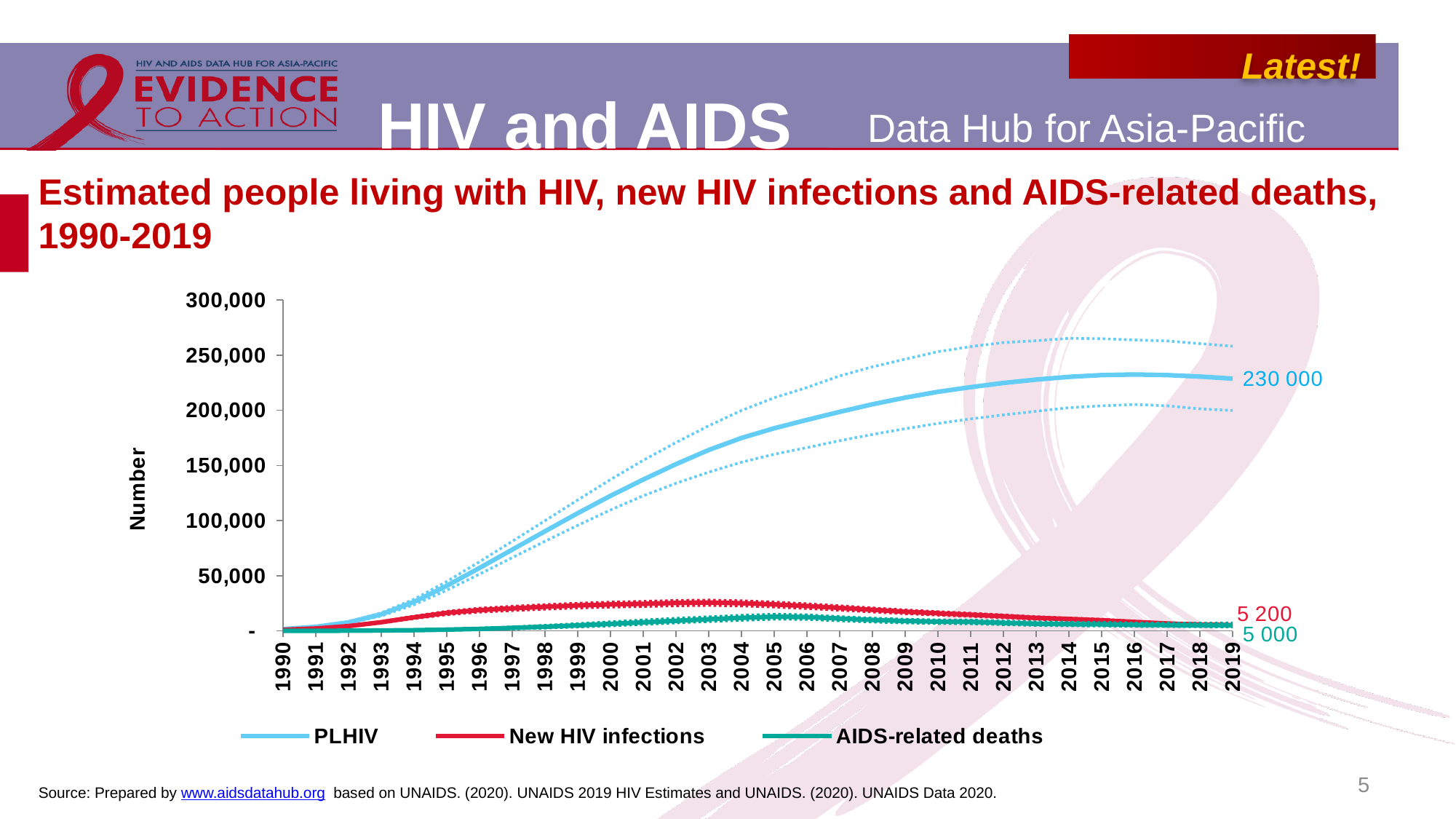
Is the value for PLHIV in 2005 greater or less than 150,000? greater Does the PLHIV line rise or fall overall from 1990 to 2019? Rise What kind of chart is shown on the slide? Line chart How many series does the legend list? 3 How many years are shown on the x axis? 30 What is the labelled value for PLHIV in 2019? 230 000 What is the labelled value for New HIV infections in 2019? 5 200 Is the value for PLHIV in 2000 greater or less than 150,000? less What is the labelled value for AIDS-related deaths in 2019? 5 000 In 2019, which is larger: New HIV infections or AIDS-related deaths? New HIV infections What is the difference between the 2019 values for New HIV infections and AIDS-related deaths? 200 Which series has the highest value in 2019? PLHIV